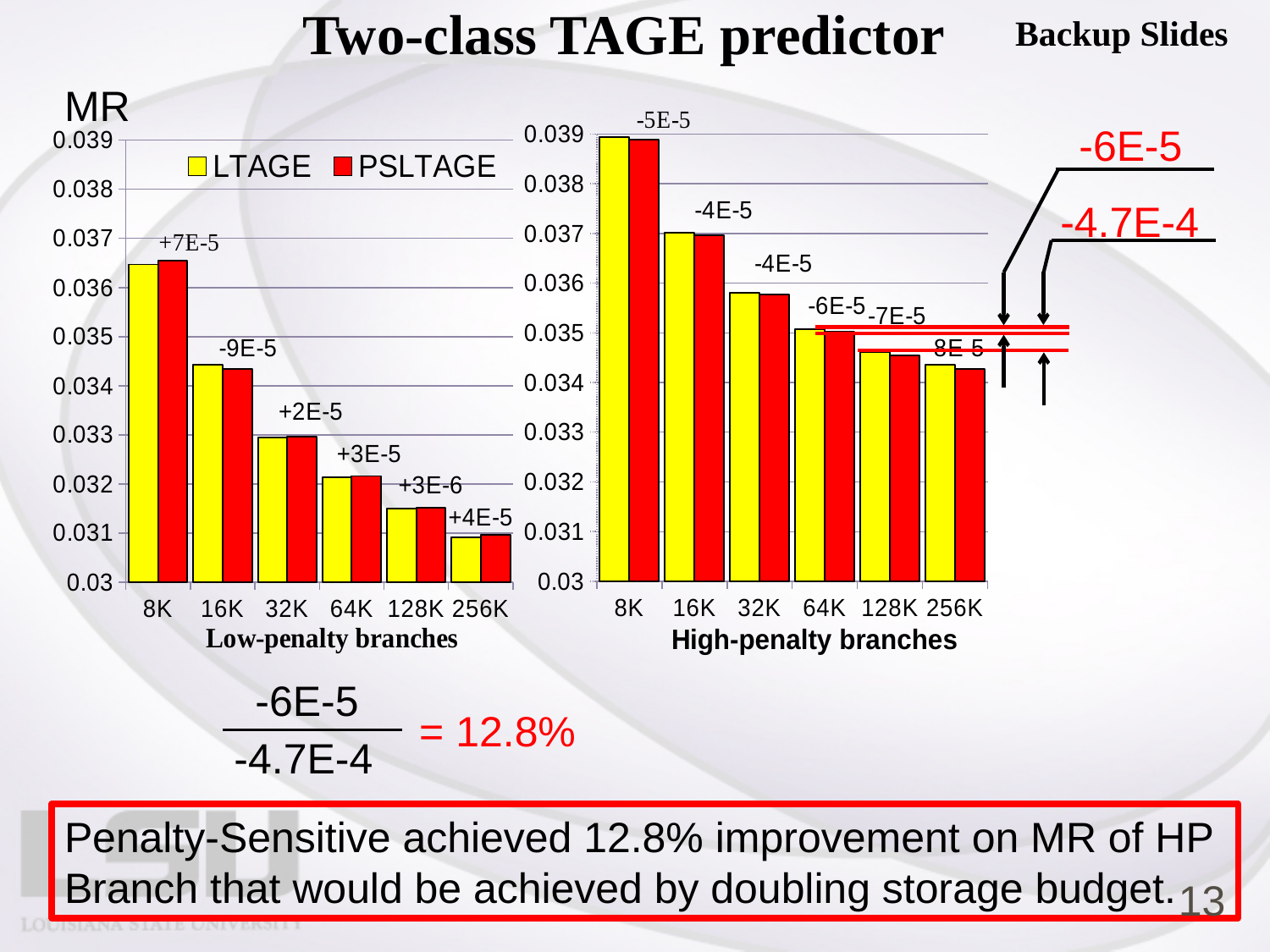
In the High-penalty branches chart, which storage budget has the lowest MR? 256K What kind of chart is the Low-penalty branches chart? bar chart How many storage budget categories are shown on the x axis of the High-penalty branches chart? 6 In the High-penalty branches chart, do the MR values rise or fall as the storage budget increases from 8K to 256K? fall In the High-penalty branches chart, is the LTAGE value for 8K greater or less than 0.038? greater How many series does the legend list for the Low-penalty branches chart? 2 In the Low-penalty branches chart, what difference label is printed above the 16K bars? -9E-5 In the Low-penalty branches chart, is the LTAGE value for 8K greater or less than 0.036? greater In the Low-penalty branches chart, which storage budget has the highest MR? 8K In the High-penalty branches chart, which is larger, the LTAGE value for 8K or the LTAGE value for 256K? 8K Which colour represents the PSLTAGE series in the charts? red In the Low-penalty branches chart, is the PSLTAGE value for 256K greater or less than 0.032? less